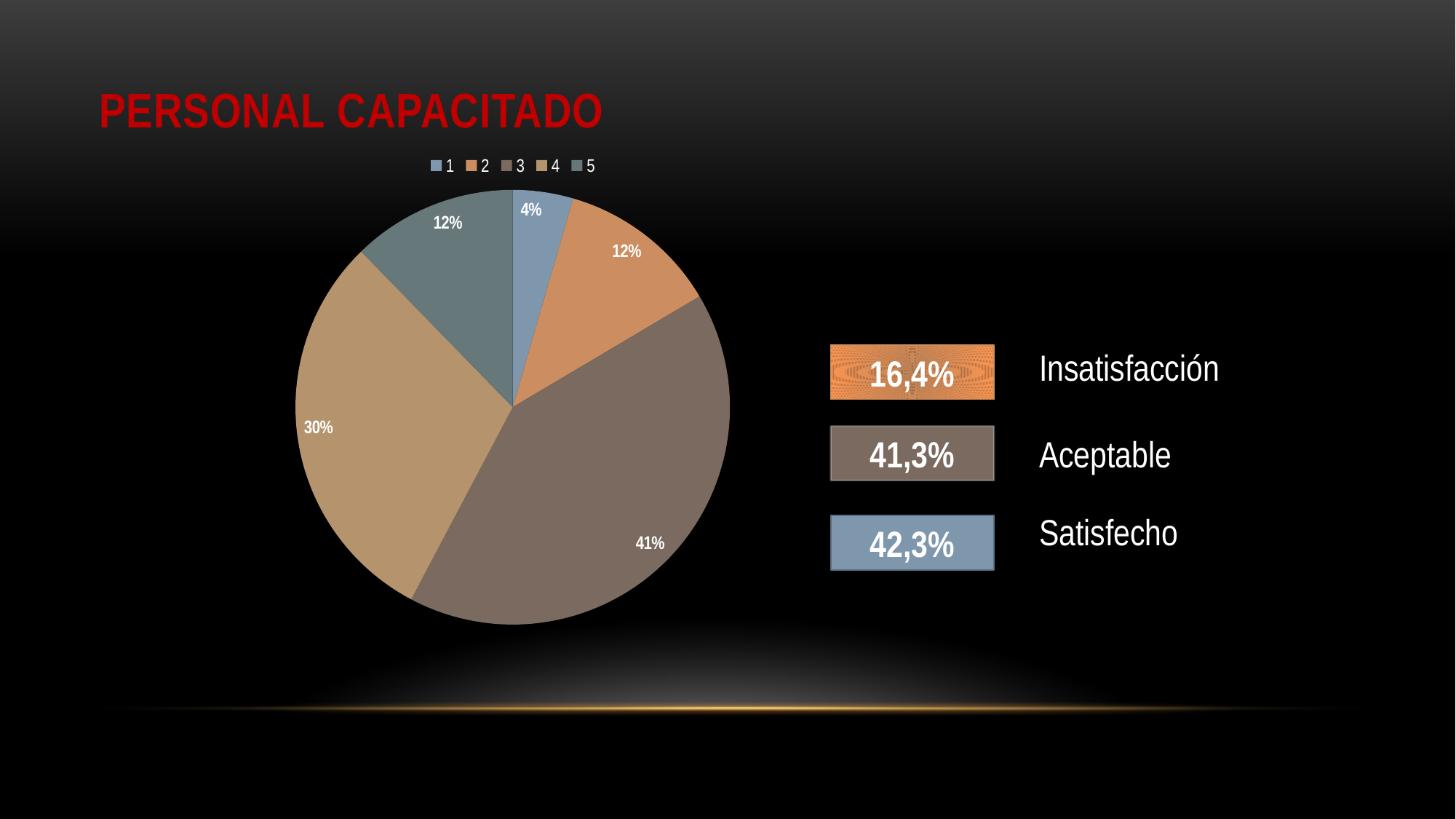
How many entries does the legend of the pie chart list? 5 What percentage does slice 1 represent in the pie chart? 4% What is the difference in percentage points between slice 3 and slice 4? 11 What kind of chart is shown on the slide? pie chart What percentage does slice 4 represent in the pie chart? 30% What is the title of the slide containing the pie chart? PERSONAL CAPACITADO How many slices does the pie chart have? 5 Which category has the smallest slice in the pie chart? 1 Which is larger in the pie chart, slice 4 or slice 5? 4 What percentage does slice 2 represent in the pie chart? 12% Which category has the largest slice in the pie chart? 3 What percentage does slice 3 represent in the pie chart? 41%